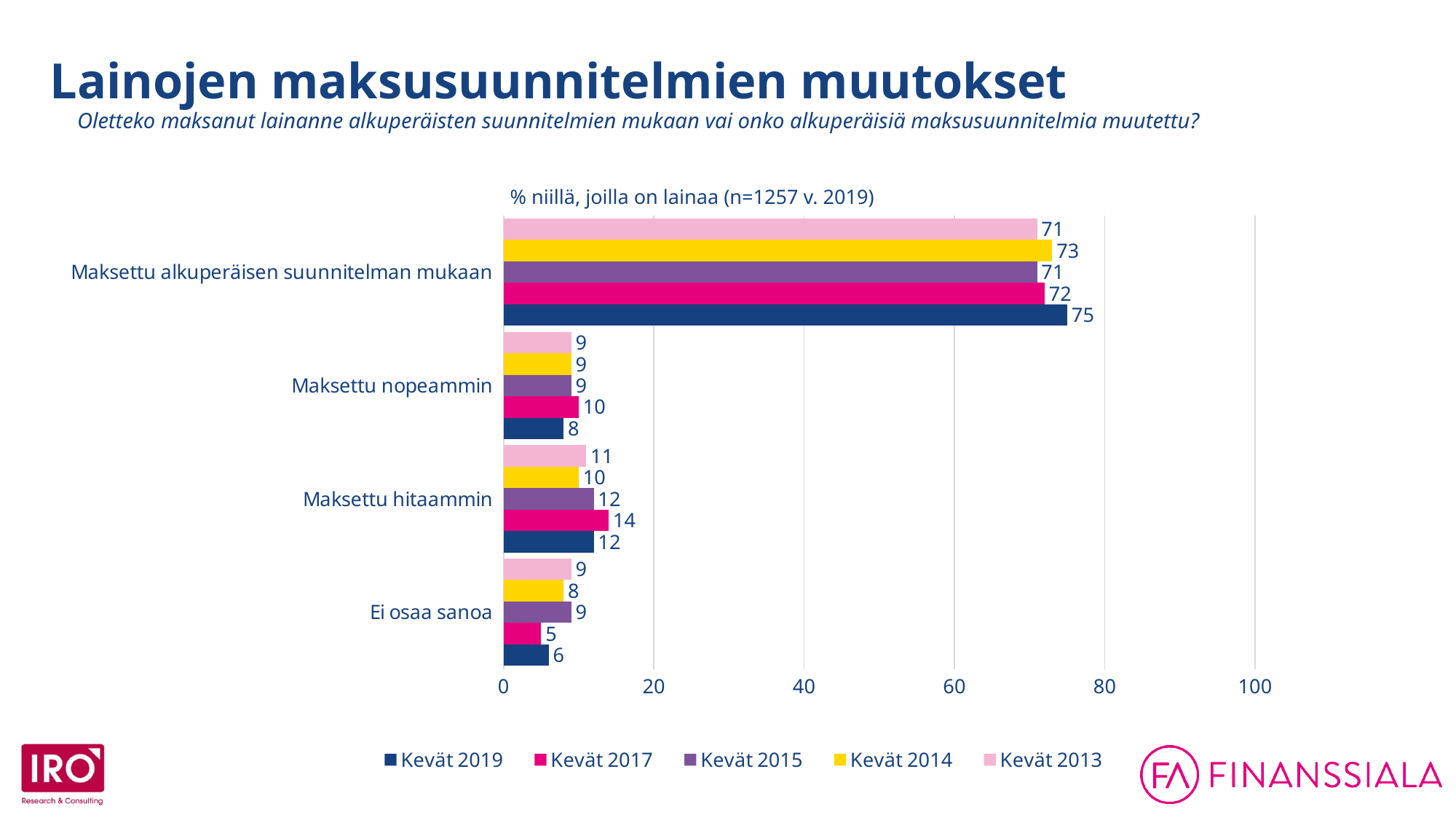
What is the value for Kevät 2017 in the category "Maksettu hitaammin"? 14 How many categories are shown on the chart? 4 Which category has the lowest value for Kevät 2017? Ei osaa sanoa What is the value for Kevät 2013 in the category "Maksettu nopeammin"? 9 What is the value for Kevät 2014 in the category "Ei osaa sanoa"? 8 What kind of chart is shown on the slide? Bar chart In the category "Maksettu hitaammin", which is larger: the Kevät 2017 value or the Kevät 2014 value? Kevät 2017 What is the difference between the Kevät 2019 and Kevät 2013 values for "Maksettu alkuperäisen suunnitelman mukaan"? 4 How many series does the legend list? 5 What is the value for Kevät 2019 in the category "Maksettu alkuperäisen suunnitelman mukaan"? 75 What is the subtitle printed above the chart? % niillä, joilla on lainaa (n=1257 v. 2019) Which category has the highest value for Kevät 2015? Maksettu alkuperäisen suunnitelman mukaan